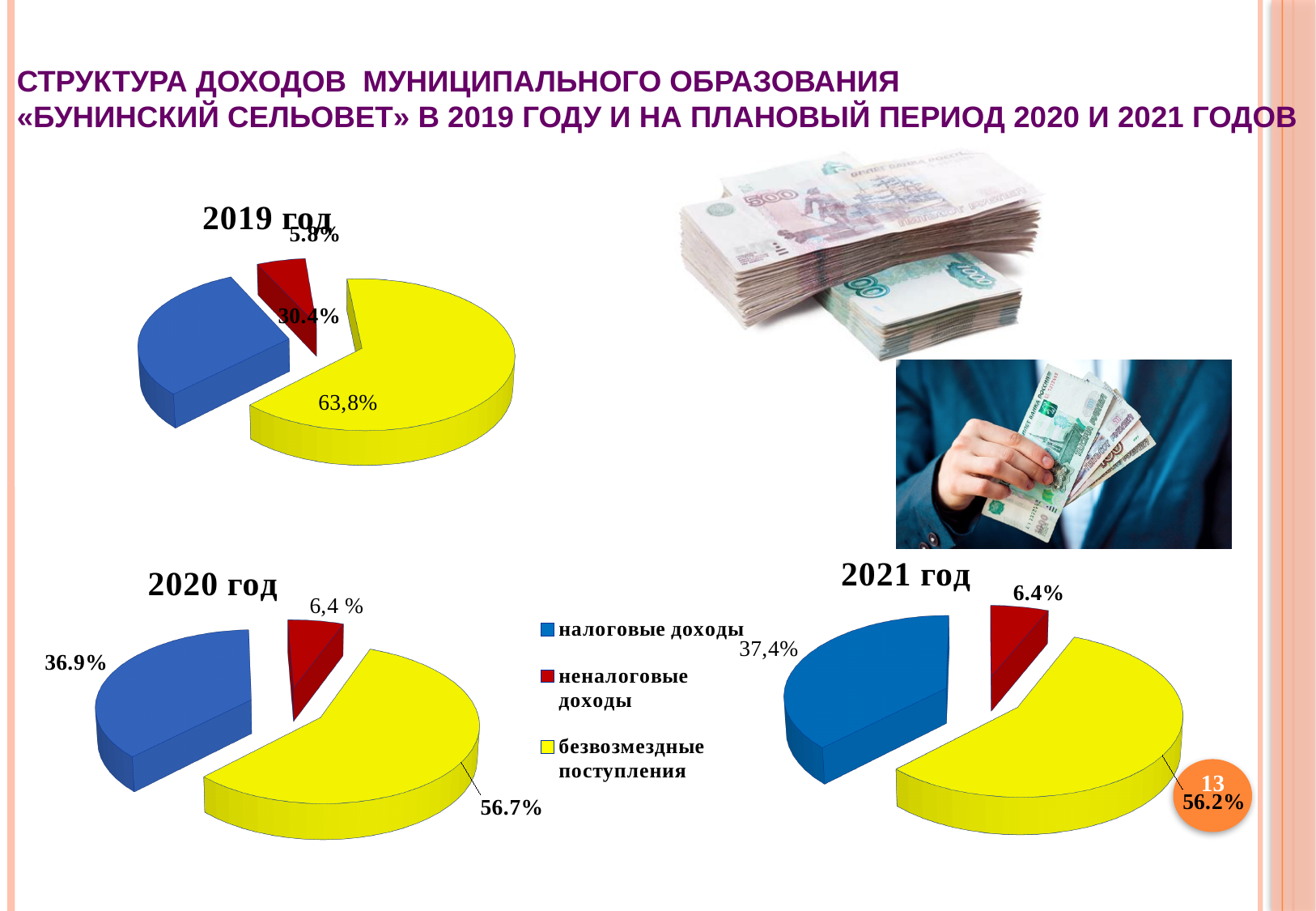
How many categories does the legend list for the pie charts? 3 What type of chart is used for '2020 год'? pie chart In the '2021 год' chart, what share is shown for безвозмездные поступления? 56.2% In the '2019 год' chart, what share is shown for безвозмездные поступления? 63,8% In the '2019 год' chart, which is larger: the share of налоговые доходы or the share of неналоговые доходы? налоговые доходы In the '2020 год' chart, what share is shown for налоговые доходы? 36.9% In the '2019 год' chart, what share is shown for налоговые доходы? 30.4% In the '2021 год' chart, which category has the smallest share? неналоговые доходы In the '2020 год' chart, which category has the largest share? безвозмездные поступления In the '2020 год' chart, what share is shown for неналоговые доходы? 6,4 % In the legend, which colour represents безвозмездные поступления? yellow In the '2021 год' chart, what share is shown for налоговые доходы? 37,4%